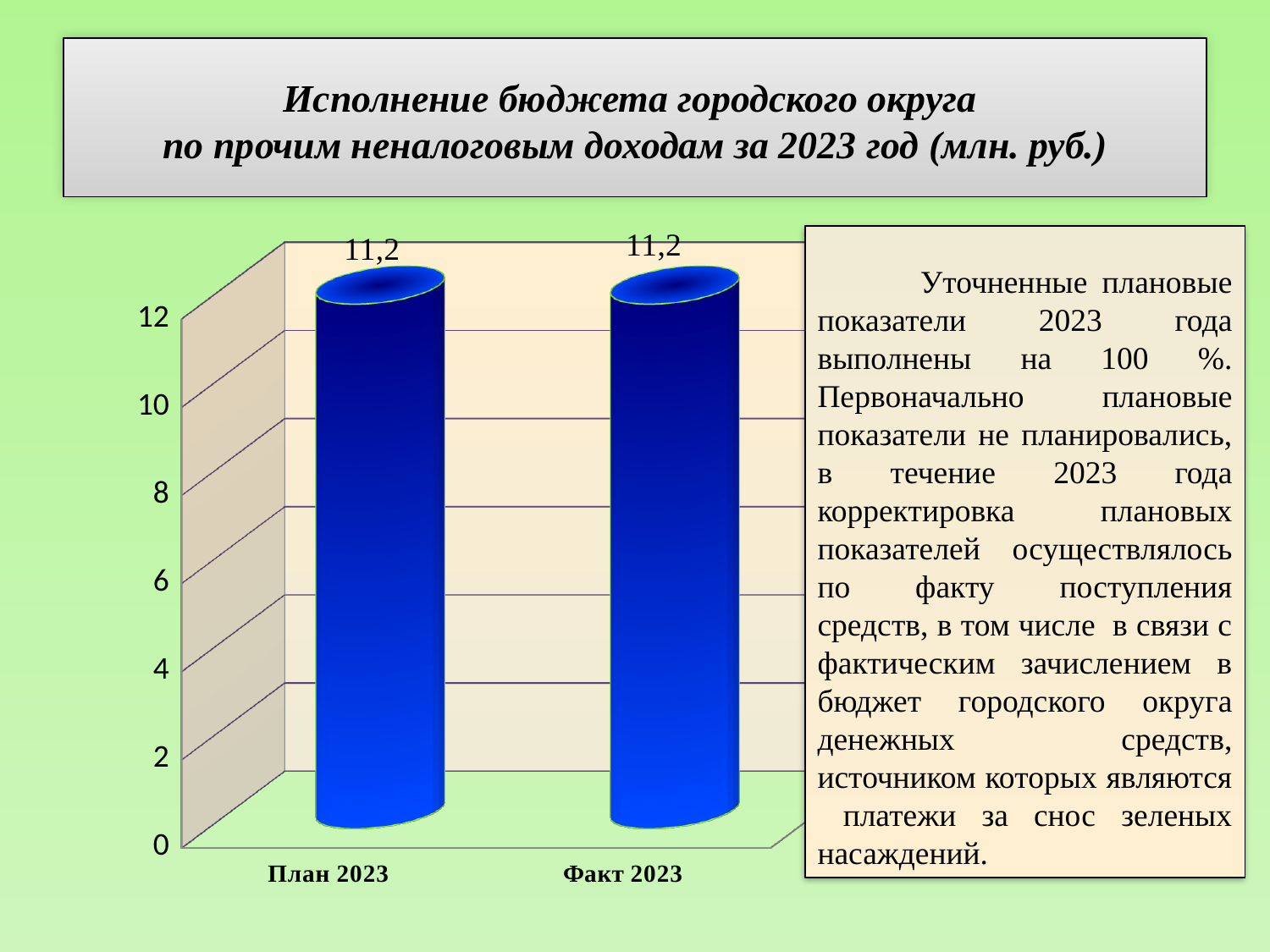
What is the value for План 2023? 11,2 What are the category labels on the horizontal axis? План 2023, Факт 2023 What is the highest value shown on the vertical axis? 12 What is the value for Факт 2023? 11,2 How many categories are shown on the chart? 2 What kind of chart is shown on the slide? bar chart Is the value for План 2023 greater or less than 10? greater What is the difference between the values for План 2023 and Факт 2023? 0